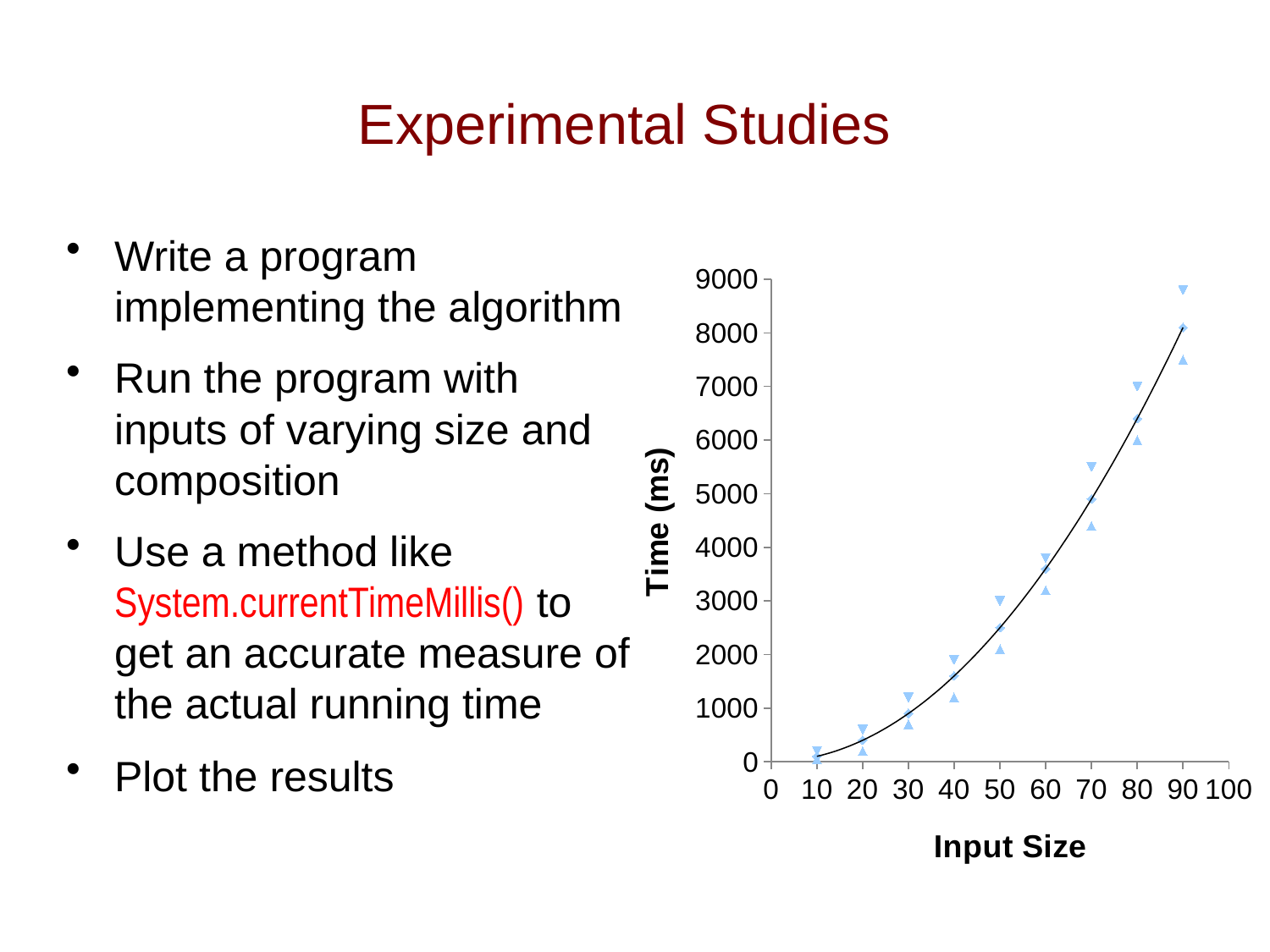
At which input size are the highest time values plotted? 90 How many distinct input sizes have data points plotted? 9 What is the label of the y axis of the chart? Time (ms) Are the time values plotted for input size 80 greater or less than 5000? greater Are the time values plotted for input size 10 greater or less than 1000? less At which input size are the lowest time values plotted? 10 Are the time values plotted for input size 90 greater or less than 7000? greater What is the label of the x axis of the chart? Input Size What kind of chart is shown on the slide? scatter chart Do the plotted time values rise or fall as input size increases? rise Which input size has larger plotted time values, 30 or 70? 70